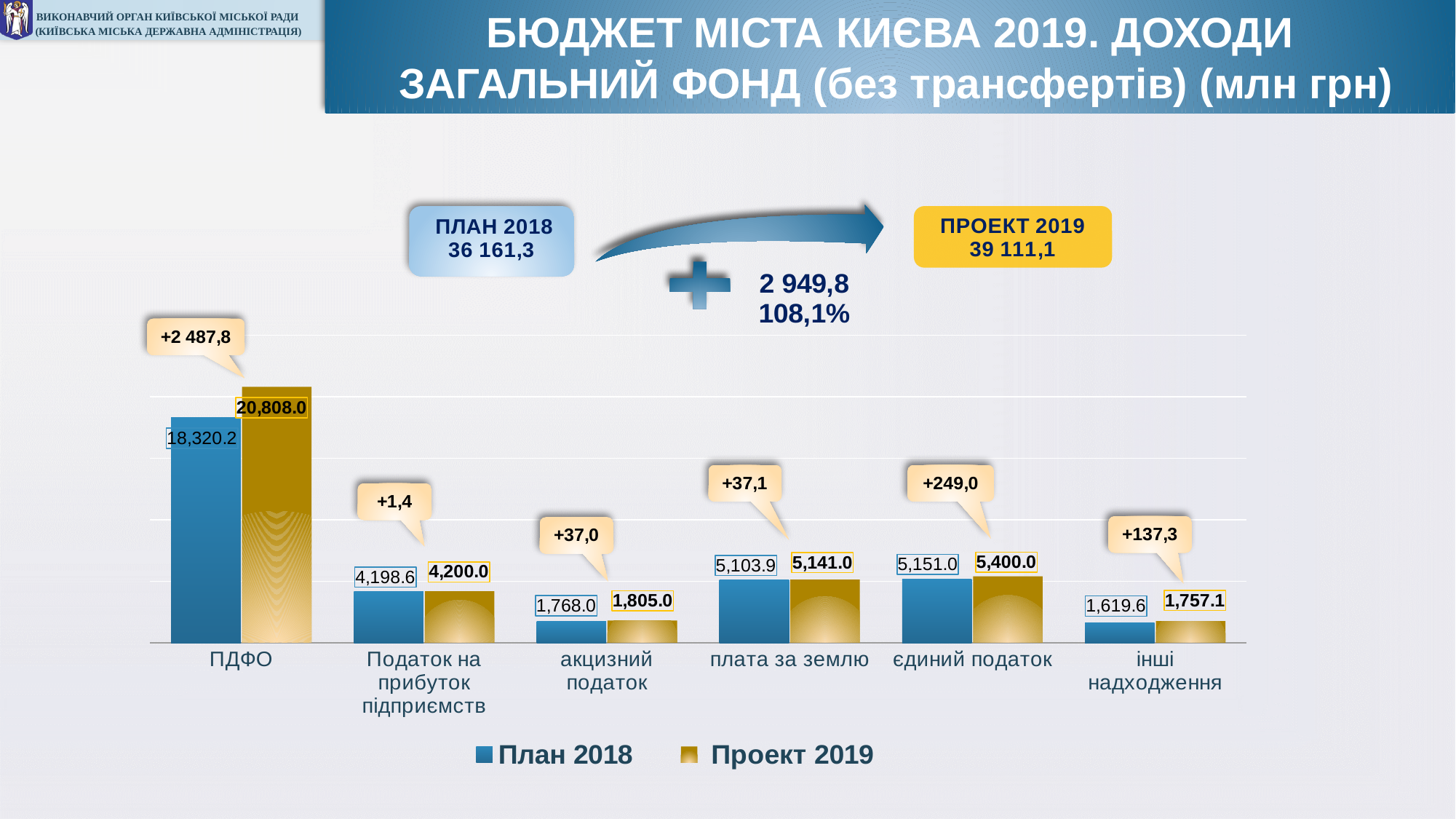
Which category has the highest Проект 2019 value? ПДФО What is the Проект 2019 value for єдиний податок? 5,400.0 What is the difference between the Проект 2019 and План 2018 values for єдиний податок? 249,0 How many categories are shown on the x axis of the chart? 6 Which is larger in Проект 2019: плата за землю or єдиний податок? єдиний податок What is the План 2018 value for акцизний податок? 1,768.0 What is the difference between the Проект 2019 and План 2018 values for ПДФО? 2 487,8 Which category has the lowest План 2018 value? інші надходження How many series does the chart legend list? 2 What is the План 2018 value for ПДФО? 18,320.2 What is the Проект 2019 value for інші надходження? 1,757.1 What kind of chart is shown on the slide? bar chart